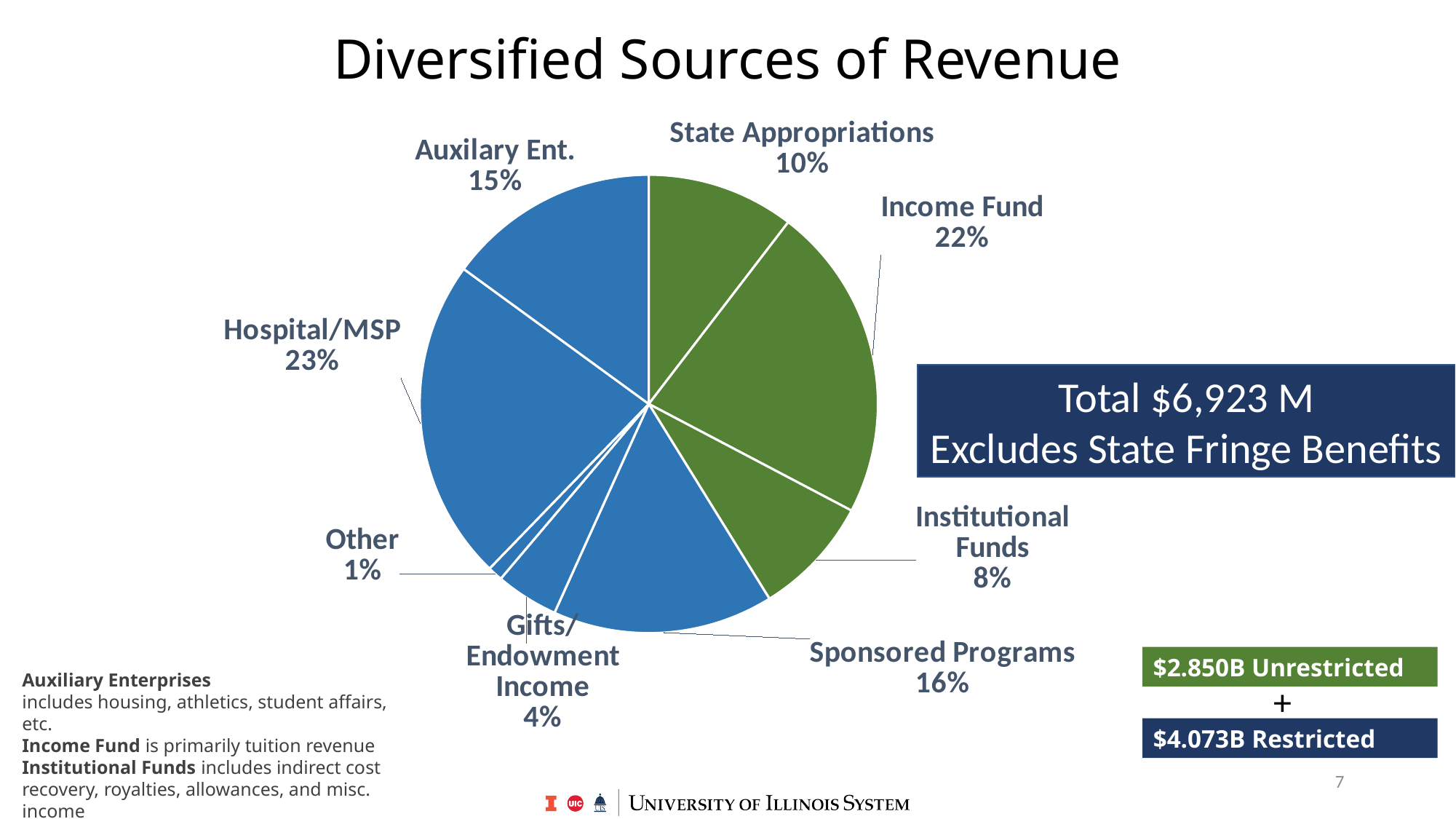
Which revenue source has the smallest share of the pie? Other What kind of chart is shown on the slide? Pie chart What share of revenue does Hospital/MSP represent? 23% Which revenue source has the largest share of the pie? Hospital/MSP How many slices does the pie chart have? 8 What is the difference in percentage points between Income Fund and State Appropriations? 12 What total revenue amount is stated next to the pie chart? $6,923 M What percentage of revenue comes from Gifts/Endowment Income? 4% Which is larger, the share for Auxilary Ent. or the share for Institutional Funds? Auxilary Ent. What is the title of the slide containing the pie chart? Diversified Sources of Revenue What share of revenue comes from the Income Fund? 22% What percentage of revenue is from Sponsored Programs? 16%